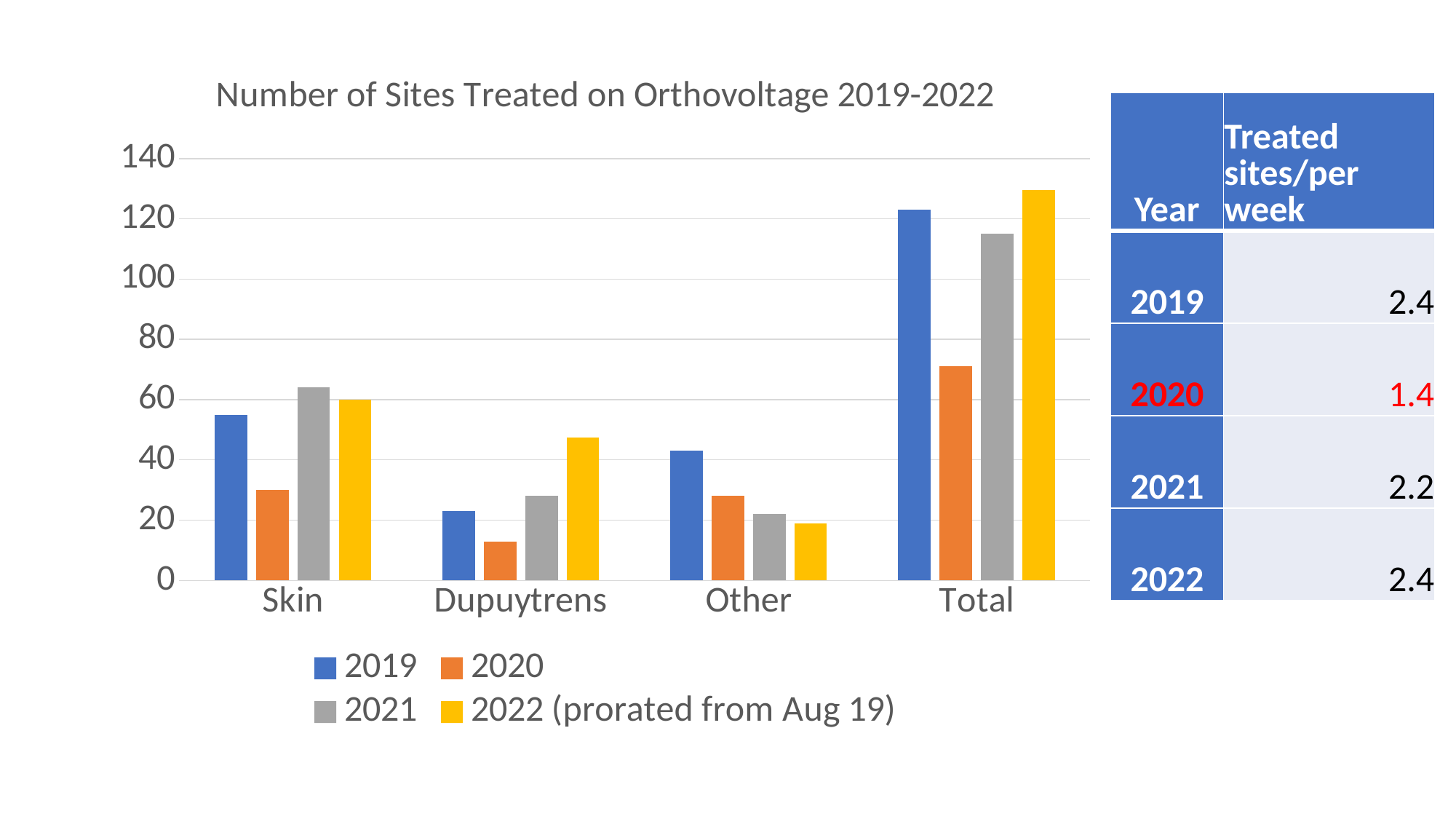
Is the 2019 value for Skin greater or less than 40? greater What is the title of the chart? Number of Sites Treated on Orthovoltage 2019-2022 What kind of chart is shown on the slide? bar chart How many categories are shown on the x axis of the chart? 4 What is the full legend label for the yellow series? 2022 (prorated from Aug 19) Which year has the lowest value in the Total category? 2020 Which category has the lowest value for the 2020 series? Dupuytrens How many series does the chart's legend list? 4 Is the 2020 value for Dupuytrens greater or less than 20? less For the Other category, do the values rise or fall from 2019 to 2022? fall For Dupuytrens, which is larger: the 2021 value or the 2022 value? 2022 Is the 2020 value for Total greater or less than 80? less